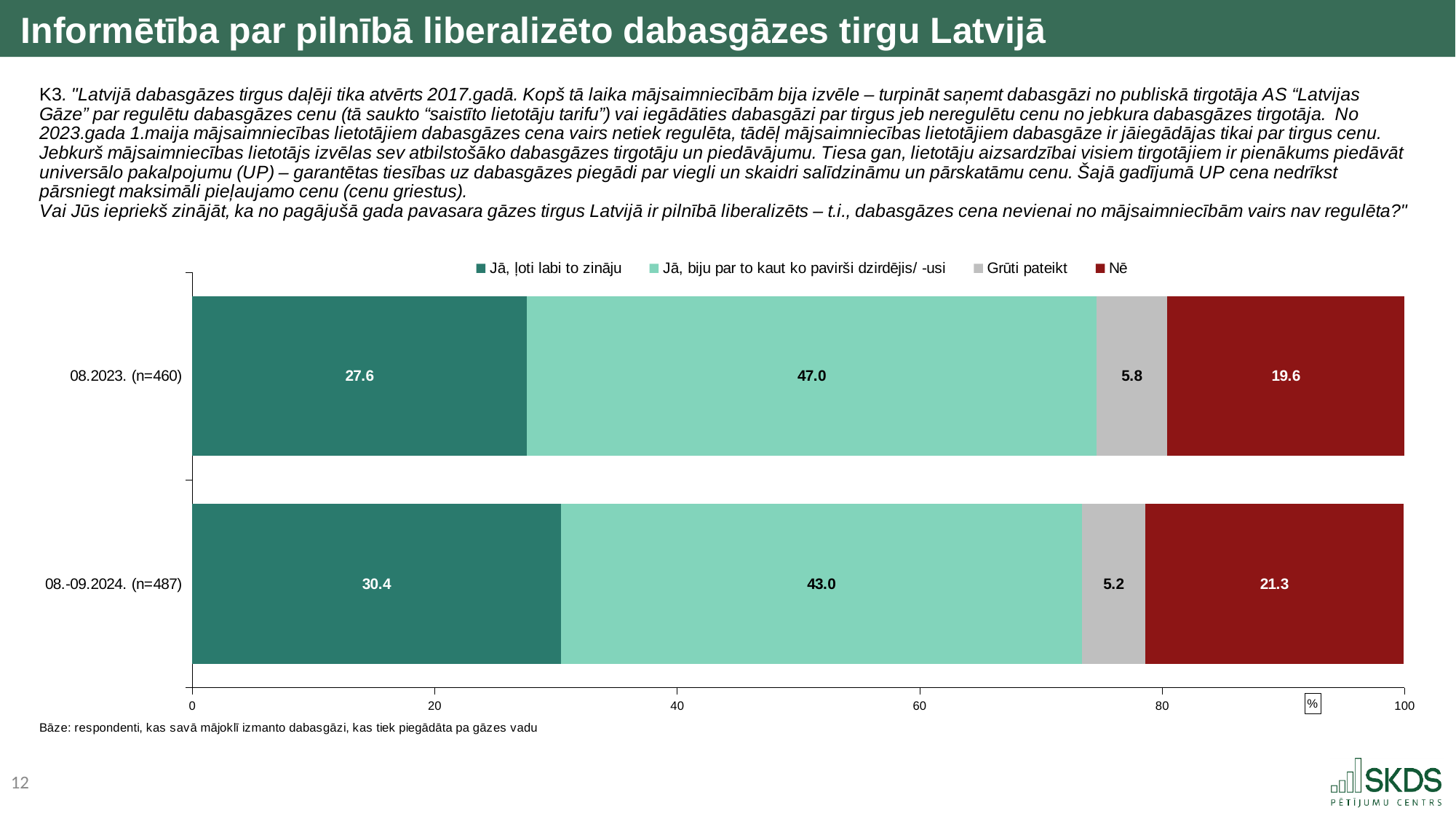
Which is larger: the "Nē" value for 08.2023. (n=460) or for 08.-09.2024. (n=487)? 08.-09.2024. (n=487) Which series has the largest value in the 08.-09.2024. (n=487) bar? Jā, biju par to kaut ko pavirši dzirdējis/ -usi How many bars (survey waves) are shown in the chart? 2 What is the value for "Nē" in the 08.-09.2024. (n=487) bar? 21.3 What is the value for "Grūti pateikt" in the 08.2023. (n=460) bar? 5.8 Which series has the smallest value in the 08.2023. (n=460) bar? Grūti pateikt What is the value for "Jā, biju par to kaut ko pavirši dzirdējis/ -usi" in the 08.-09.2024. (n=487) bar? 43.0 What is the total of the 08.2023. (n=460) stacked bar? 100.0 What is the value for "Jā, ļoti labi to zināju" in the 08.2023. (n=460) bar? 27.6 What kind of chart is shown on the slide? Stacked bar chart What is the difference between the "Jā, ļoti labi to zināju" values for 08.-09.2024. (n=487) and 08.2023. (n=460)? 2.8 How many series does the legend list? 4